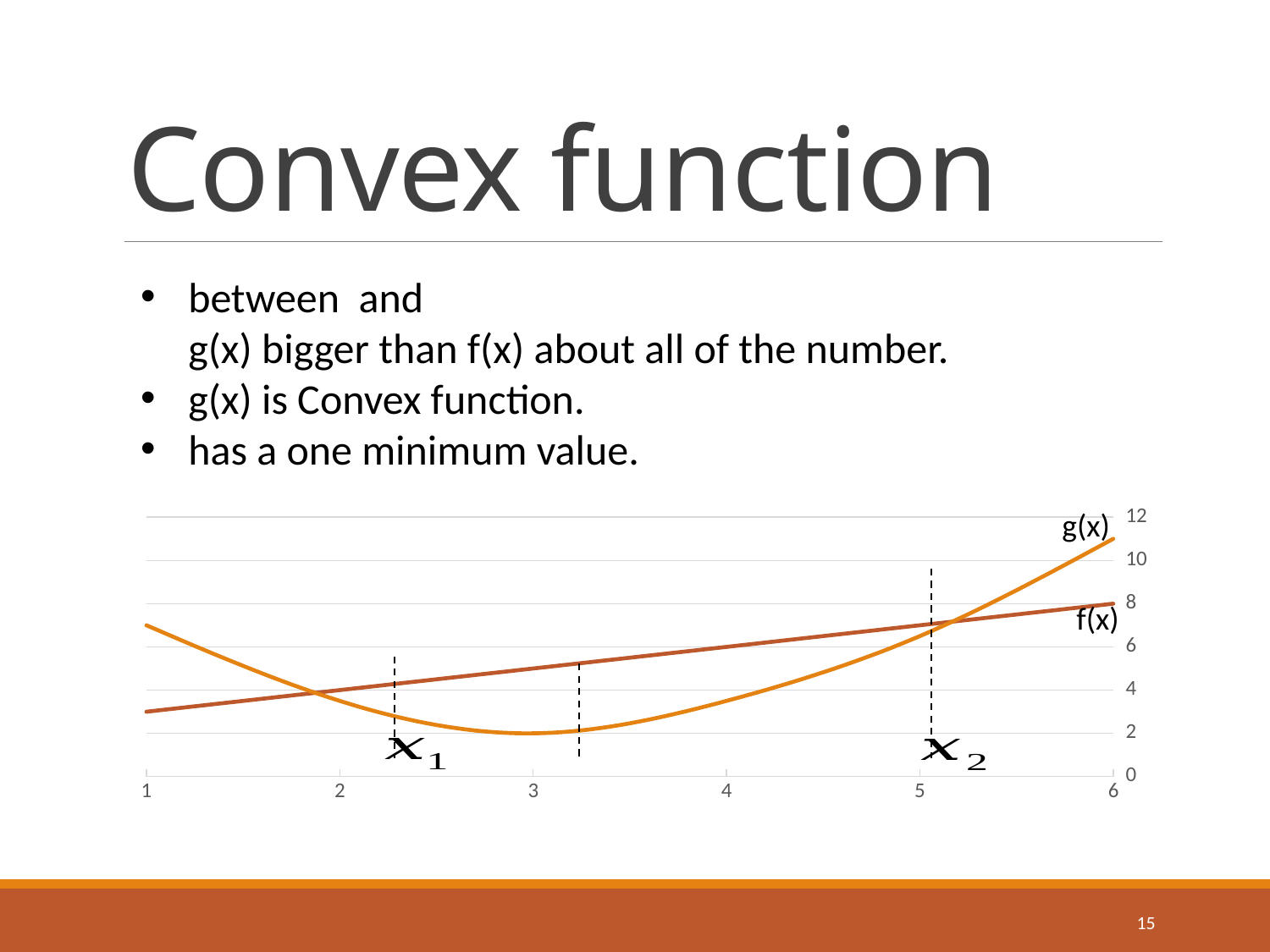
How many curves are plotted on the chart? 2 What kind of chart is shown on the slide? line chart At x = 4, which curve has the larger value, f(x) or g(x)? f(x) On which side of the chart is the y axis drawn? right Does f(x) rise or fall as x increases from 1 to 6? rise What is the highest tick label on the y axis of the chart? 12 Is the value of g(x) at x = 1 greater or less than 6? greater Is the value of f(x) at x = 1 greater or less than 4? less How many tick labels are shown on the x axis of the chart? 6 Is the value of g(x) at x = 4 greater or less than 4? less At x = 6, which curve has the larger value, f(x) or g(x)? g(x)